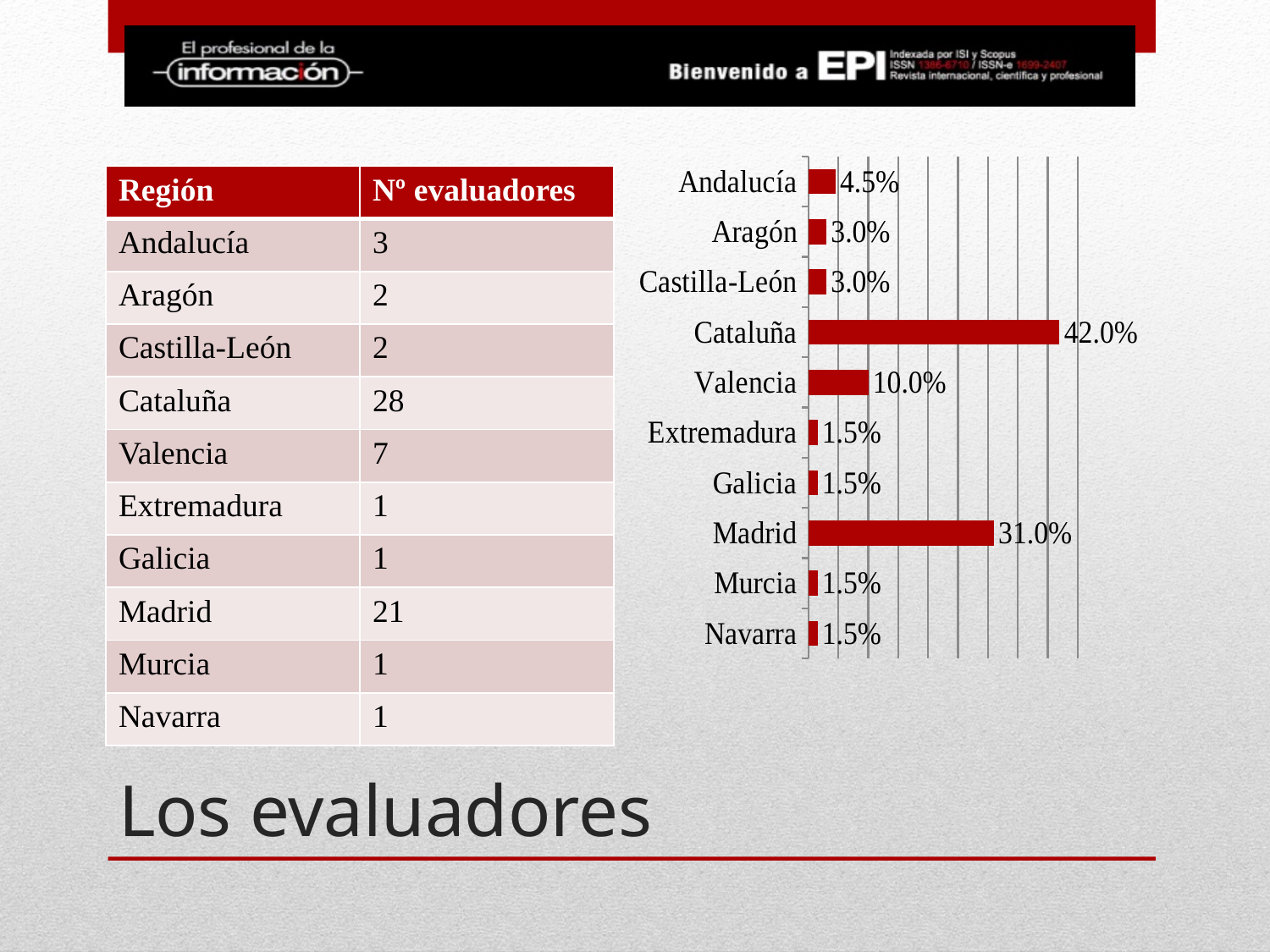
What is the difference between the values for Cataluña and Madrid in the bar chart? 11.0% What colour are the bars in the chart? Red What is the difference between the values for Madrid and Valencia in the bar chart? 21.0% How many regions are shown in the bar chart? 10 How many regions in the bar chart have a value of 1.5%? 4 What kind of chart is shown on the slide? Bar chart Which region has the highest value in the bar chart? Cataluña What is the value shown for Andalucía in the bar chart? 4.5% Which has a larger value in the bar chart, Valencia or Andalucía? Valencia What is the value shown for Madrid in the bar chart? 31.0% What is the value shown for Valencia in the bar chart? 10.0% What is the value shown for Cataluña in the bar chart? 42.0%